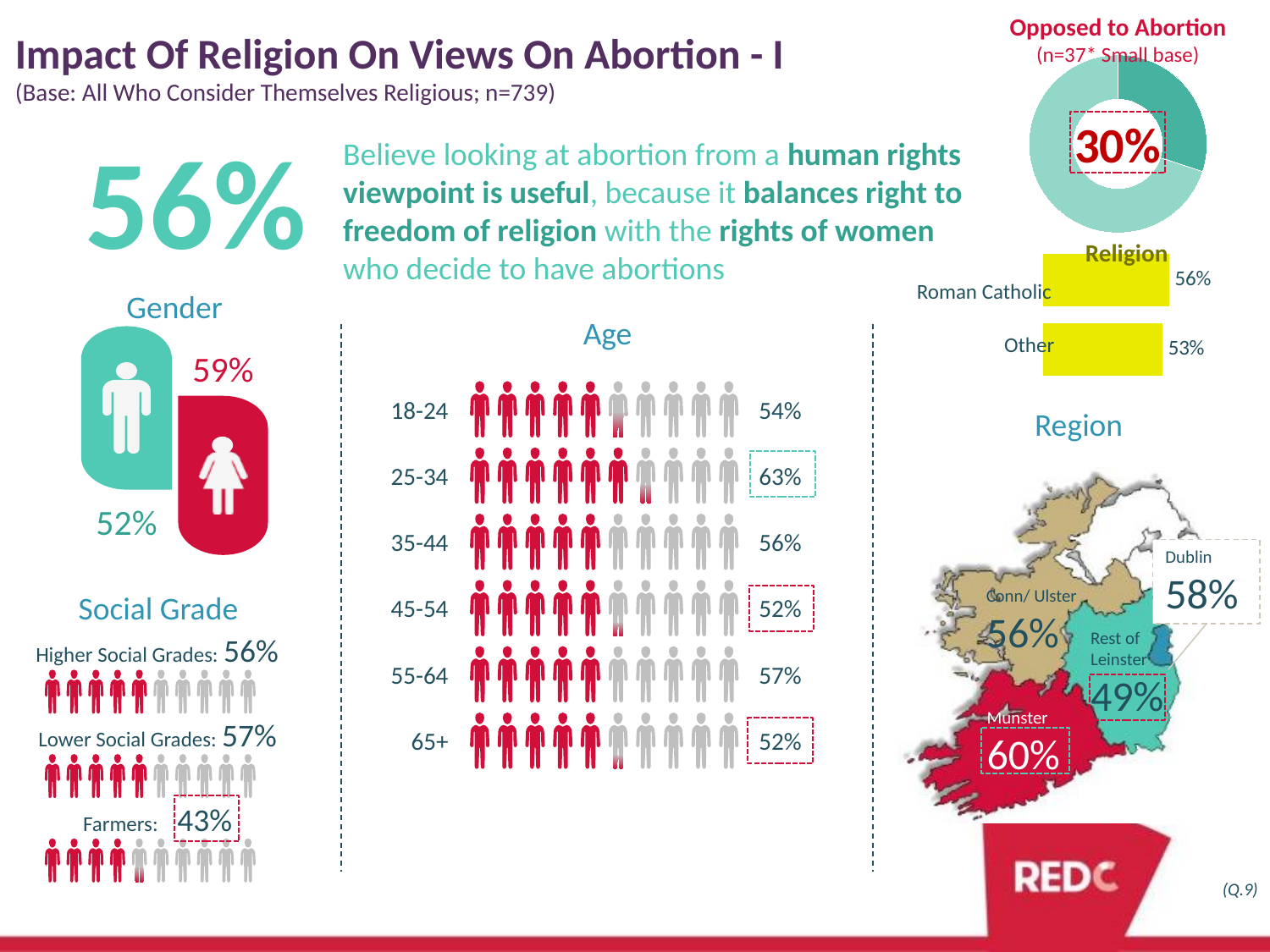
In the Age chart, how many age groups are shown? 6 In the Opposed to Abortion donut chart, what percentage is shown in the centre? 30% In the Religion bar chart, how many categories are shown? 2 In the Social Grade chart, what is the value for Farmers? 43% In the Religion bar chart, what is the difference between the Roman Catholic and Other values? 3% In the Age chart, what is the value for the 25-34 age group? 63% In the Region map, which region has the highest value? Munster In the Age chart, which age group has the highest value? 25-34 In the Religion bar chart, what is the value for Roman Catholic? 56% In the Gender chart, which is larger, the male value or the female value? Male (59%) In the Religion bar chart, what is the value for Other? 53% In the Age chart, what is the difference between the 25-34 and 65+ values? 11%